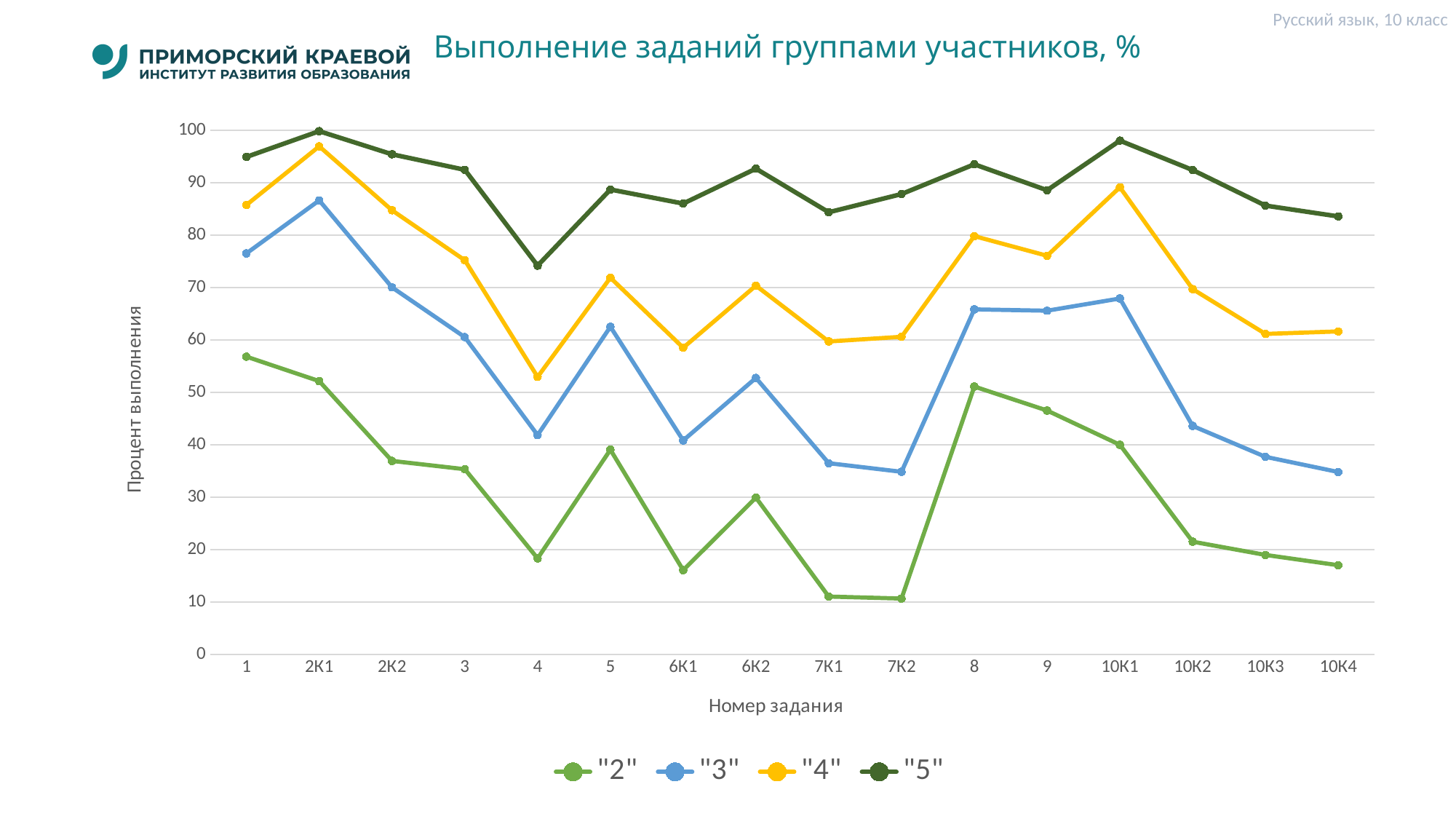
Is the value of series "3" for task 2К1 greater or less than 80? greater For which task is the value of series "2" the highest? 1 For which task is the value of series "4" the lowest? 4 For series "4", which task has the larger value: 8 or 9? 8 Is the value of series "5" for task 7К1 greater or less than 80? greater What kind of chart is shown on the slide? line chart Is the value of series "2" for task 4 greater or less than 20? less Does the value of series "2" rise or fall from task 10К1 to task 10К4? fall How many series does the legend list? 4 How many task numbers are shown along the x axis? 16 For which task is the value of series "5" the lowest? 4